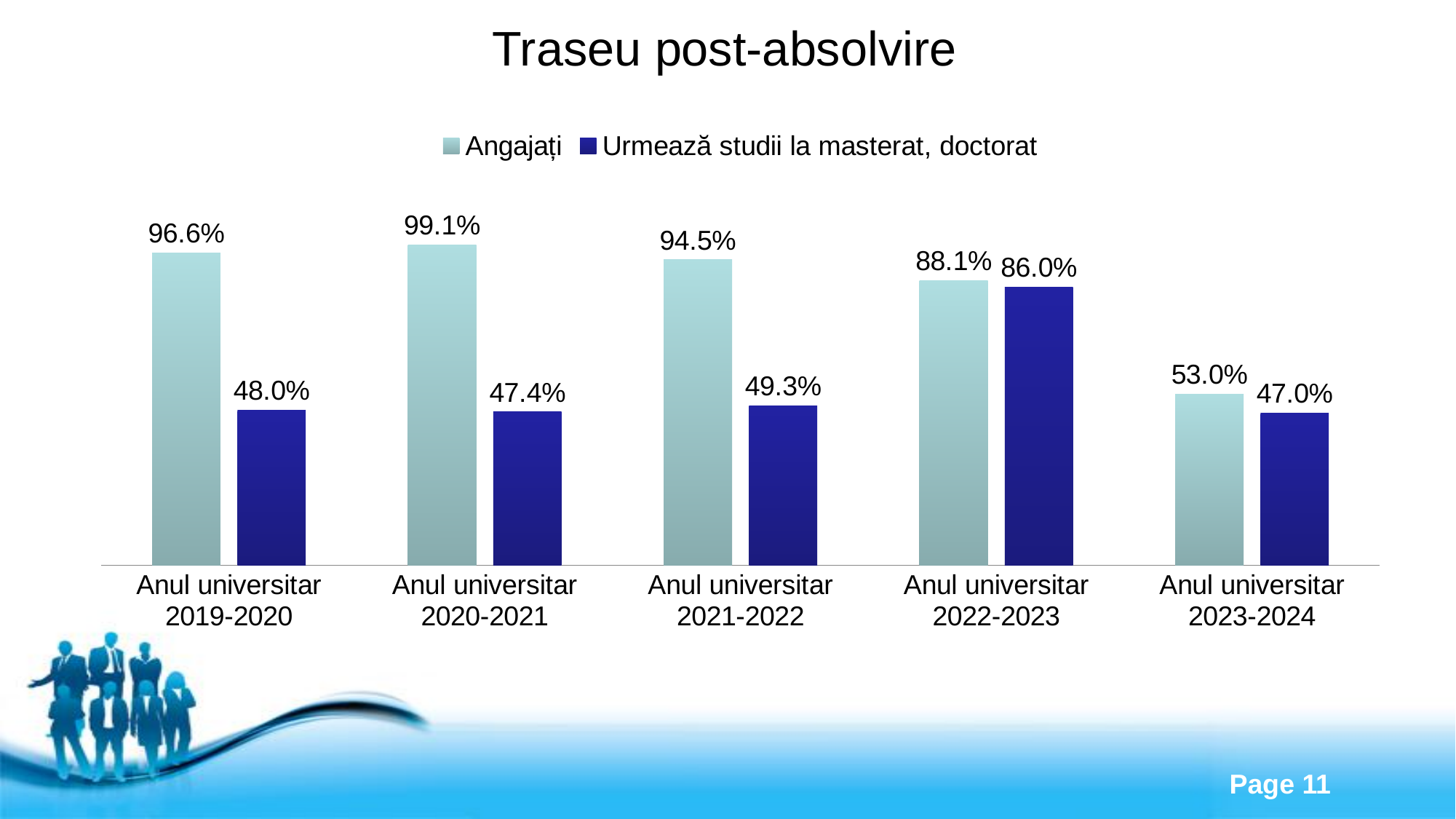
What is the difference between Angajați and Urmează studii la masterat, doctorat in Anul universitar 2019-2020? 48.6% What is the value for Angajați in Anul universitar 2023-2024? 53.0% How many academic years are shown on the x axis? 5 What is the value for Urmează studii la masterat, doctorat in Anul universitar 2022-2023? 86.0% Which academic year has the highest value for Angajați? Anul universitar 2020-2021 What is the title of the slide? Traseu post-absolvire Which is larger in Anul universitar 2021-2022: Angajați or Urmează studii la masterat, doctorat? Angajați Which academic year has the lowest value for Angajați? Anul universitar 2023-2024 Which academic year has the highest value for Urmează studii la masterat, doctorat? Anul universitar 2022-2023 What kind of chart is shown on the slide? Bar chart What is the value for Angajați in Anul universitar 2020-2021? 99.1% How many series does the legend list? 2